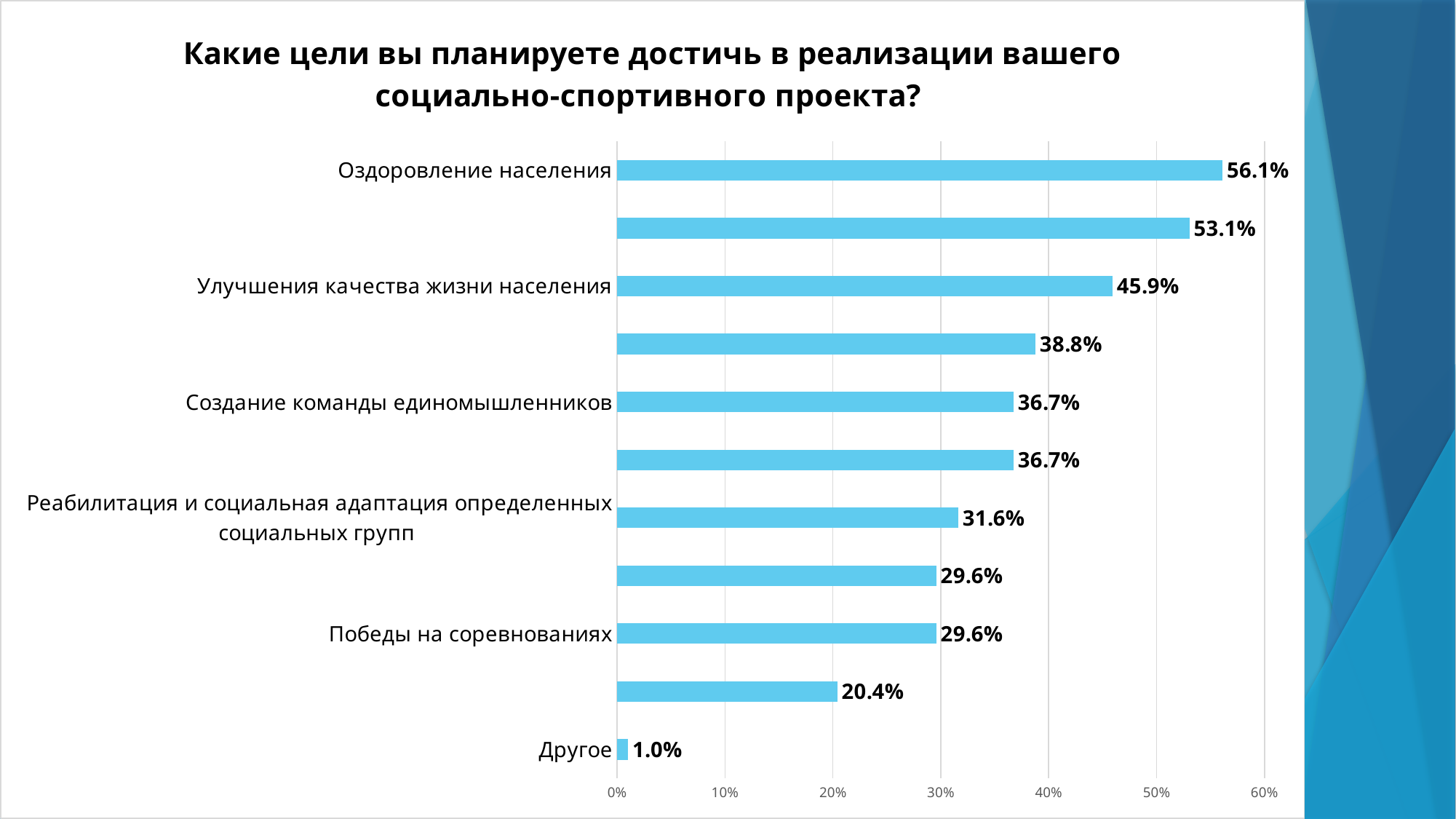
What value is shown for "Создание команды единомышленников"? 36.7% Which category has the highest value? Оздоровление населения Is the value for "Реабилитация и социальная адаптация определенных социальных групп" greater or less than 40%? less How many bars are plotted in the chart? 11 Which category has the lowest value? Другое What value is shown for "Реабилитация и социальная адаптация определенных социальных групп"? 31.6% Which is larger: the value for "Создание команды единомышленников" or the value for "Победы на соревнованиях"? Создание команды единомышленников What value is shown for "Оздоровление населения"? 56.1% What type of chart is shown on the slide? Bar chart What is the difference between the values for "Оздоровление населения" and "Улучшения качества жизни населения"? 10.2% What value is shown for "Улучшения качества жизни населения"? 45.9% What value is shown for "Победы на соревнованиях"? 29.6%